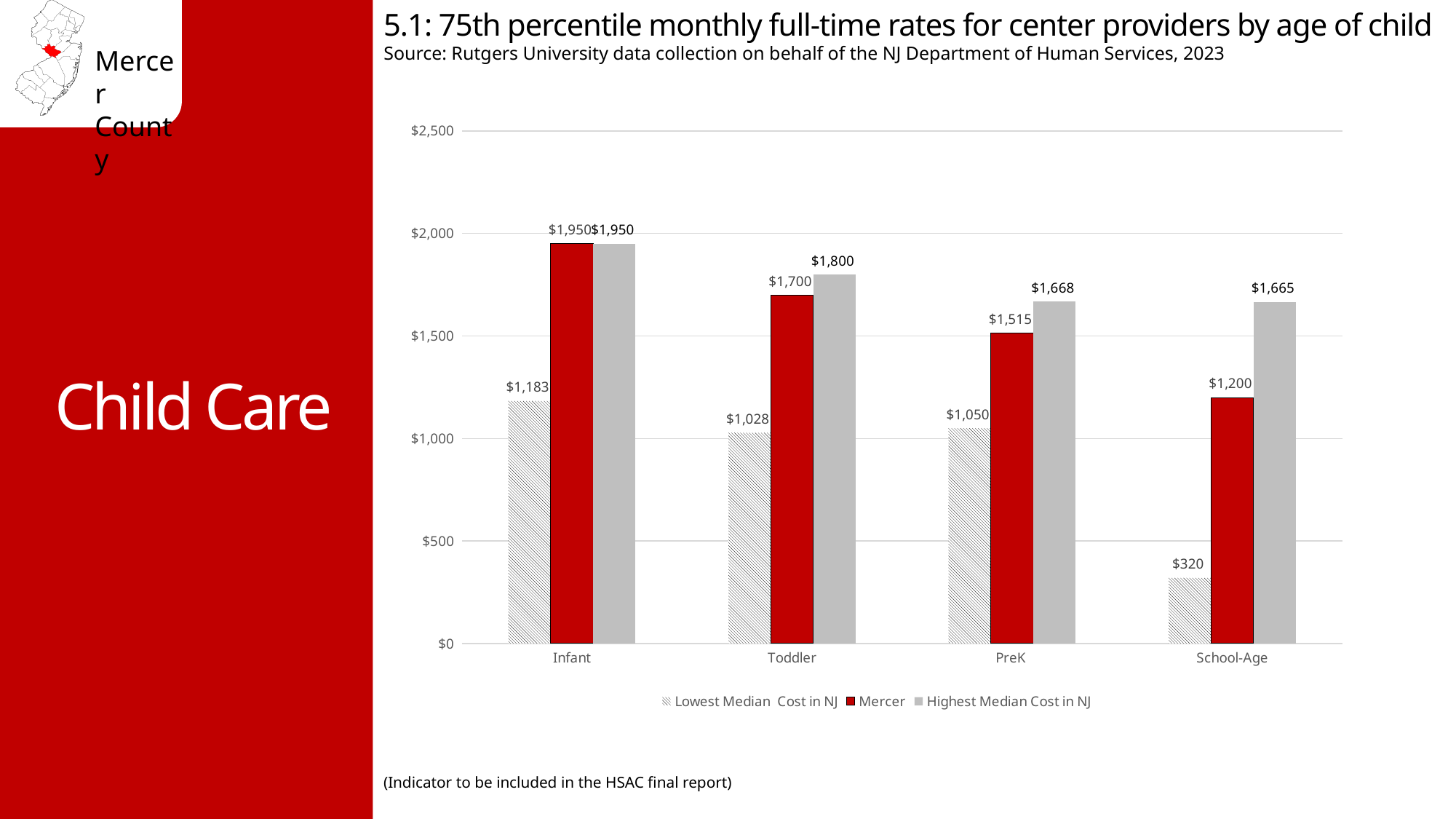
How many series does the legend list? 3 What is the difference between the Highest Median Cost in NJ and the Mercer value for School-Age? $465 What is the Mercer value for Toddler? $1,700 What kind of chart is shown? bar chart Is the Mercer value for PreK greater or less than $1,000? greater Which age group has the lowest Lowest Median Cost in NJ value? School-Age What is the Lowest Median Cost in NJ for School-Age? $320 Which is larger for Toddler: the Mercer value or the Highest Median Cost in NJ? Highest Median Cost in NJ Do the Mercer values rise or fall from Infant to School-Age? fall Which age group has the highest Mercer value? Infant How many age groups are shown on the x axis? 4 What is the Highest Median Cost in NJ for PreK? $1,668